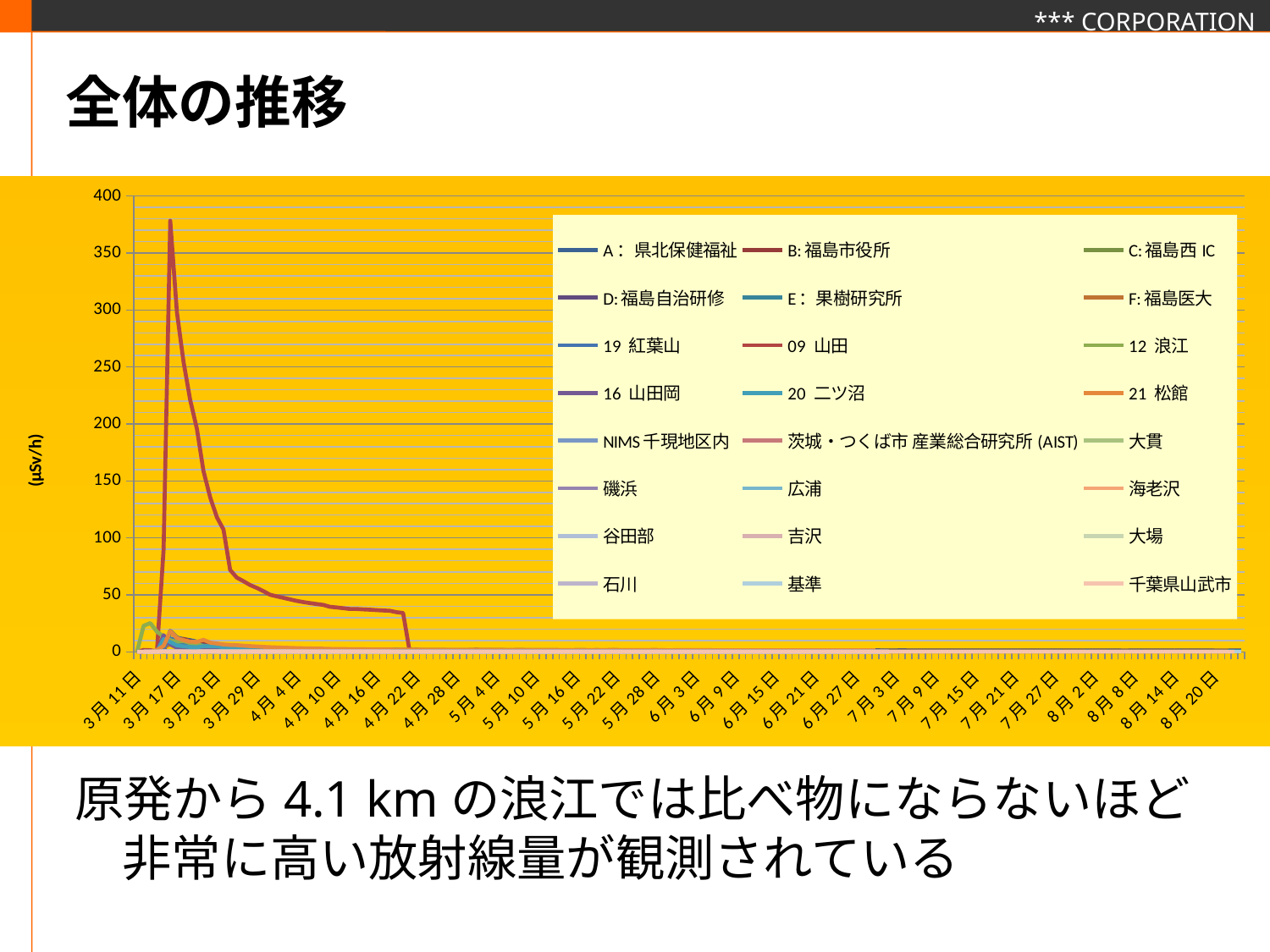
Is the peak value reached by the highest line in the chart greater or less than 350? greater What unit is shown on the y-axis of the chart? μSv/h Is the peak value reached by the highest line in the chart greater or less than 400? less How many series does the chart's legend list? 24 After its peak in mid-March, does the highest line in the chart rise or fall over the following weeks? fall Around 4月16日, is the value of the highest line in the chart greater or less than 50? less What kind of chart is shown on the slide? line chart What is the first date label on the x-axis of the chart? 3月11日